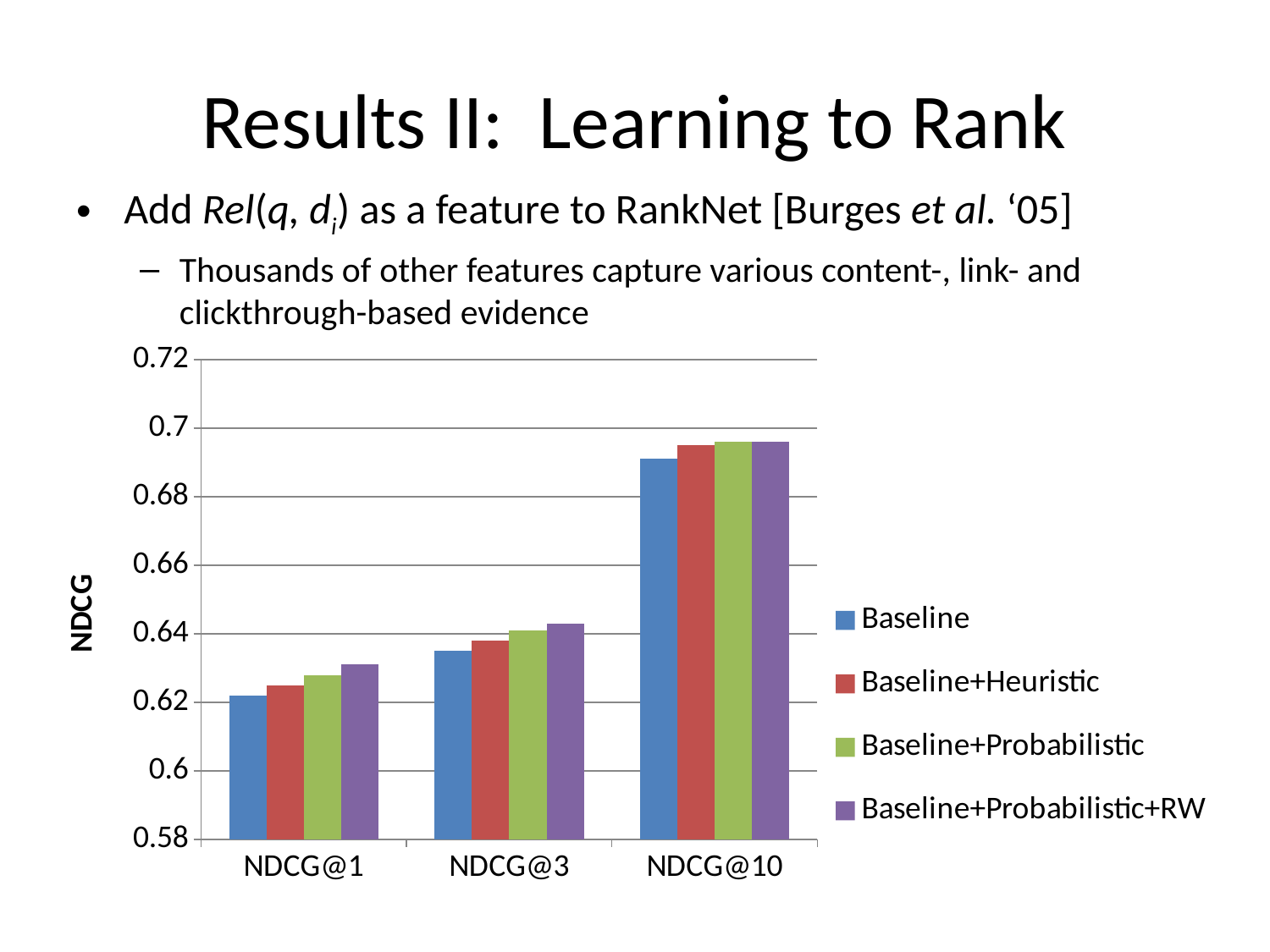
Is the Baseline value for NDCG@10 greater or less than 0.7? less How many categories are shown on the x axis of the chart? 3 What kind of chart is shown on the slide? bar chart Do the Baseline values rise or fall from NDCG@1 to NDCG@10? rise Is the Baseline value for NDCG@1 greater or less than 0.64? less Is the Baseline value for NDCG@10 greater or less than 0.68? greater Within the NDCG@1 category, which series has the lowest value? Baseline For NDCG@10, which is larger: the Baseline value or the Baseline+Heuristic value? Baseline+Heuristic For which category is the Baseline value highest? NDCG@10 How many series does the chart's legend list? 4 For NDCG@1, which is larger: the Baseline value or the Baseline+Probabilistic+RW value? Baseline+Probabilistic+RW